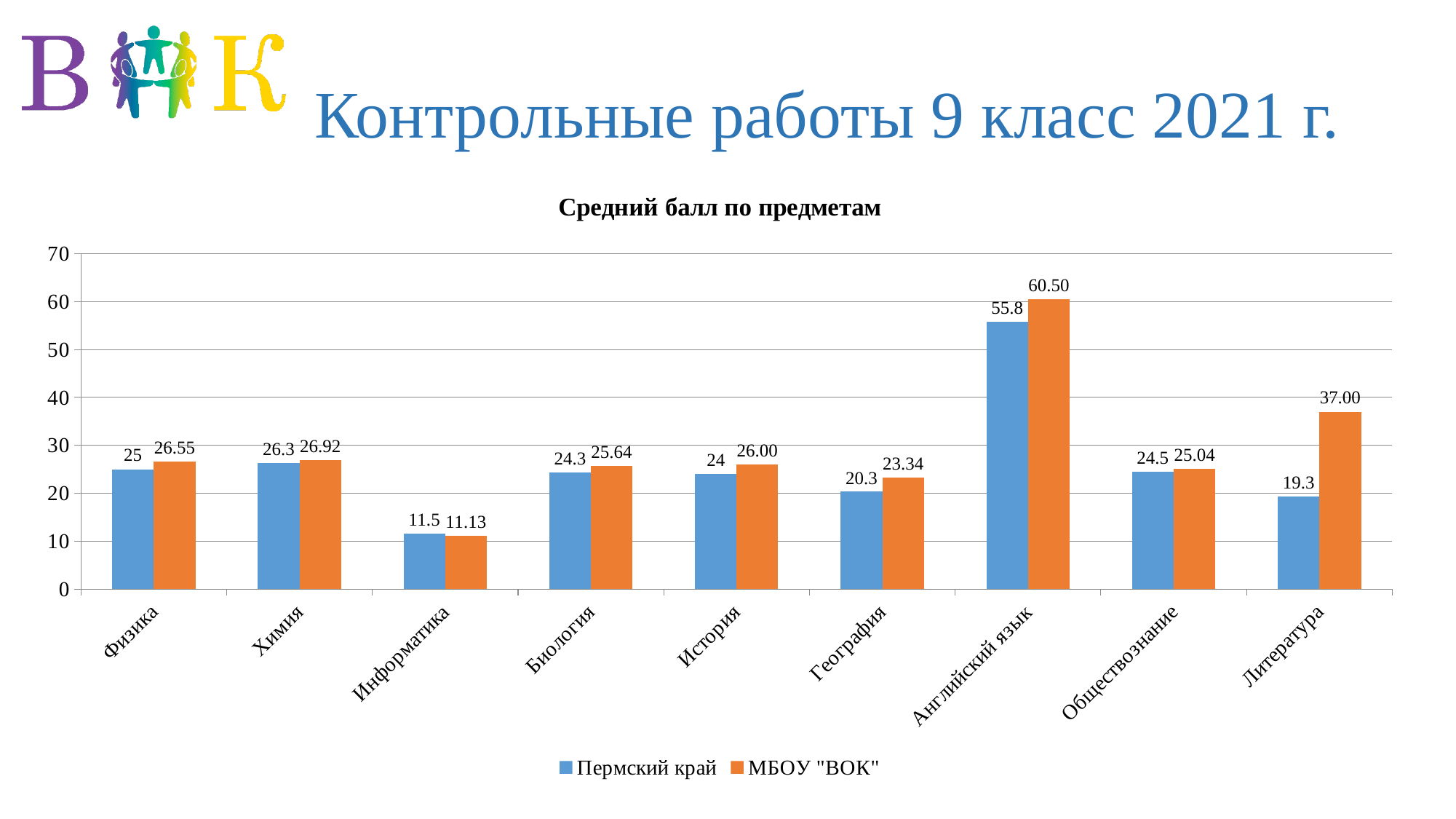
What type of chart is shown? bar chart What is the difference between МБОУ "ВОК" and Пермский край in Литература? 17.7 What is the difference between МБОУ "ВОК" and Пермский край in Английский язык? 4.7 What is the value for МБОУ "ВОК" in Литература? 37.00 Which subject has the lowest value for Пермский край? Информатика In Информатика, which is larger: Пермский край or МБОУ "ВОК"? Пермский край Which subject has the highest value for МБОУ "ВОК"? Английский язык How many subjects are shown on the x axis? 9 How many series does the legend list? 2 What is the value for МБОУ "ВОК" in Информатика? 11.13 Is the value for МБОУ "ВОК" in Английский язык greater or less than 50? greater What is the value for Пермский край in Физика? 25